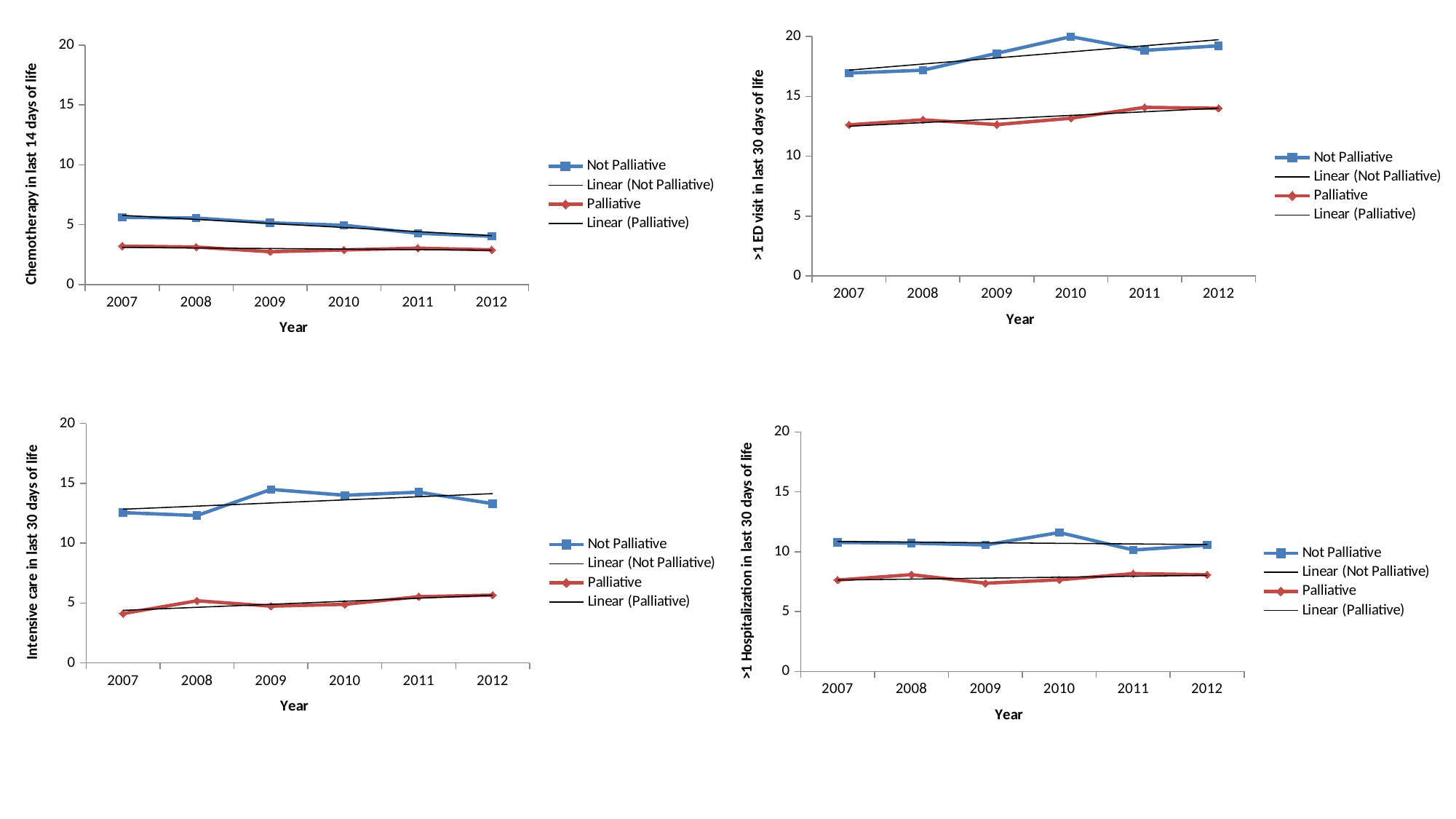
In the top-right chart, '>1 ED visit in last 30 days of life', how many entries does the legend list? 4 In the top-left chart, 'Chemotherapy in last 14 days of life', does the Not Palliative line rise or fall from 2007 to 2012? Fall What kind of chart is the top-left chart, 'Chemotherapy in last 14 days of life'? Line chart In the bottom-left chart, 'Intensive care in last 30 days of life', in which year is the Palliative value lowest? 2007 In the top-right chart, '>1 ED visit in last 30 days of life', which series has the larger value in 2012, Not Palliative or Palliative? Not Palliative In the top-left chart, 'Chemotherapy in last 14 days of life', how many years are plotted along the x axis? 6 In the bottom-left chart, 'Intensive care in last 30 days of life', is the Not Palliative value for 2009 greater or less than 10? greater In the top-right chart, '>1 ED visit in last 30 days of life', is the Palliative value for 2007 greater or less than 15? less In the top-right chart, '>1 ED visit in last 30 days of life', in which year is the Not Palliative value highest? 2010 In the top-left chart, 'Chemotherapy in last 14 days of life', is the Not Palliative value for 2007 greater or less than 5? greater In the bottom-right chart, '>1 Hospitalization in last 30 days of life', in which year is the Not Palliative value highest? 2010 In the bottom-right chart, '>1 Hospitalization in last 30 days of life', what colour is the Palliative line? Red